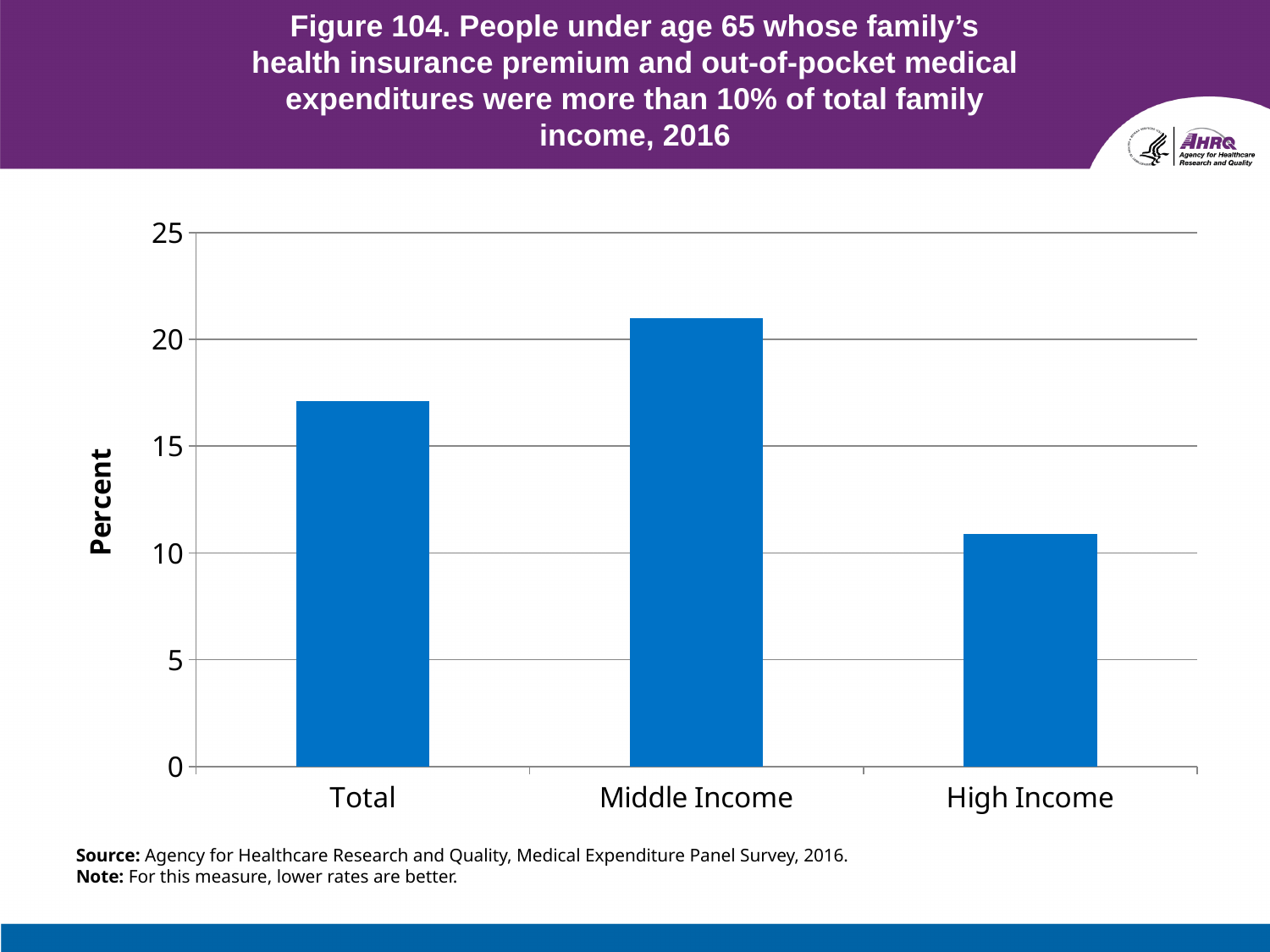
Which is larger, the value for Total or the value for High Income? Total How many categories are plotted on the x axis? 3 Is the value for High Income greater or less than 10? greater Is the value for Total greater or less than 15? greater Which category has the highest value? Middle Income Is the value for High Income greater or less than 15? less What is the maximum value shown on the vertical axis? 25 Which is larger, the value for Middle Income or the value for Total? Middle Income Which category has the lowest value? High Income What kind of chart is shown on the slide? bar chart What is the label on the vertical axis? Percent